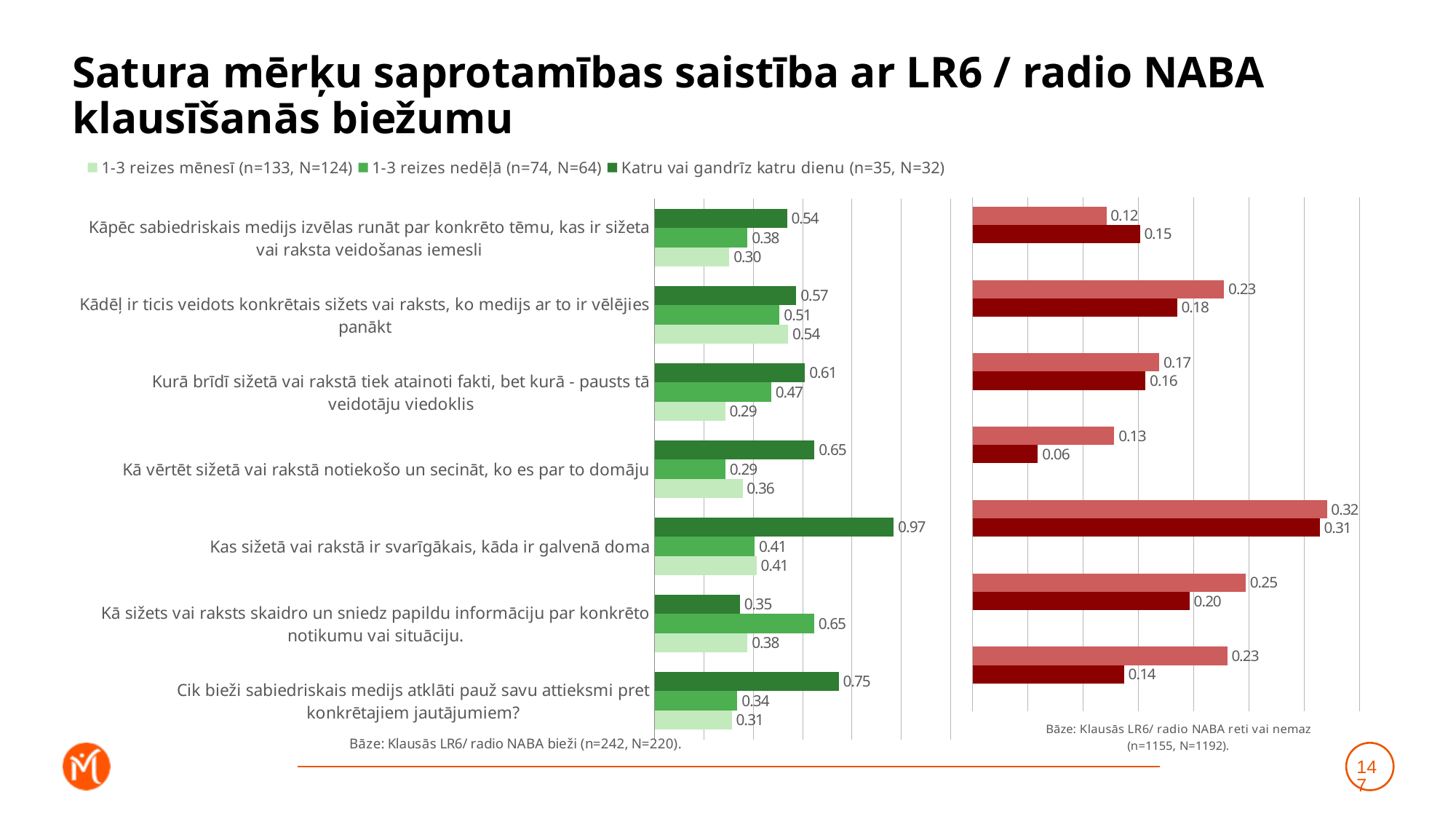
In the left (green) chart, for "Kādēļ ir ticis veidots konkrētais sižets vai raksts, ko medijs ar to ir vēlējies panākt", which is larger: the "1-3 reizes mēnesī" value or the "1-3 reizes nedēļā" value? 1-3 reizes mēnesī How many series does the legend of the left (green) chart list? 3 In the left (green) chart, what is the value for "1-3 reizes mēnesī" for the category "Kā vērtēt sižetā vai rakstā notiekošo un secināt, ko es par to domāju"? 0.36 What kind of chart is the left (green) chart? Bar chart In the left (green) chart, which category has the lowest value for "1-3 reizes nedēļā"? Kā vērtēt sižetā vai rakstā notiekošo un secināt, ko es par to domāju How many categories (statements) are shown in the left (green) chart? 7 In the right (red) chart, what is the value of the darker red bar for "Kā vērtēt sižetā vai rakstā notiekošo un secināt, ko es par to domāju"? 0.06 In the right (red) chart, what is the highest value shown? 0.32 In the left (green) chart, which category has the highest value for "Katru vai gandrīz katru dienu"? Kas sižetā vai rakstā ir svarīgākais, kāda ir galvenā doma In the left (green) chart, which legend entry corresponds to the darkest green bars? Katru vai gandrīz katru dienu (n=35, N=32) In the left (green) chart, what is the value for "Katru vai gandrīz katru dienu" for the category "Kas sižetā vai rakstā ir svarīgākais, kāda ir galvenā doma"? 0.97 In the left (green) chart, for "Kā sižets vai raksts skaidro un sniedz papildu informāciju par konkrēto notikumu vai situāciju.", how much larger is the "1-3 reizes nedēļā" value than the "Katru vai gandrīz katru dienu" value? 0.30